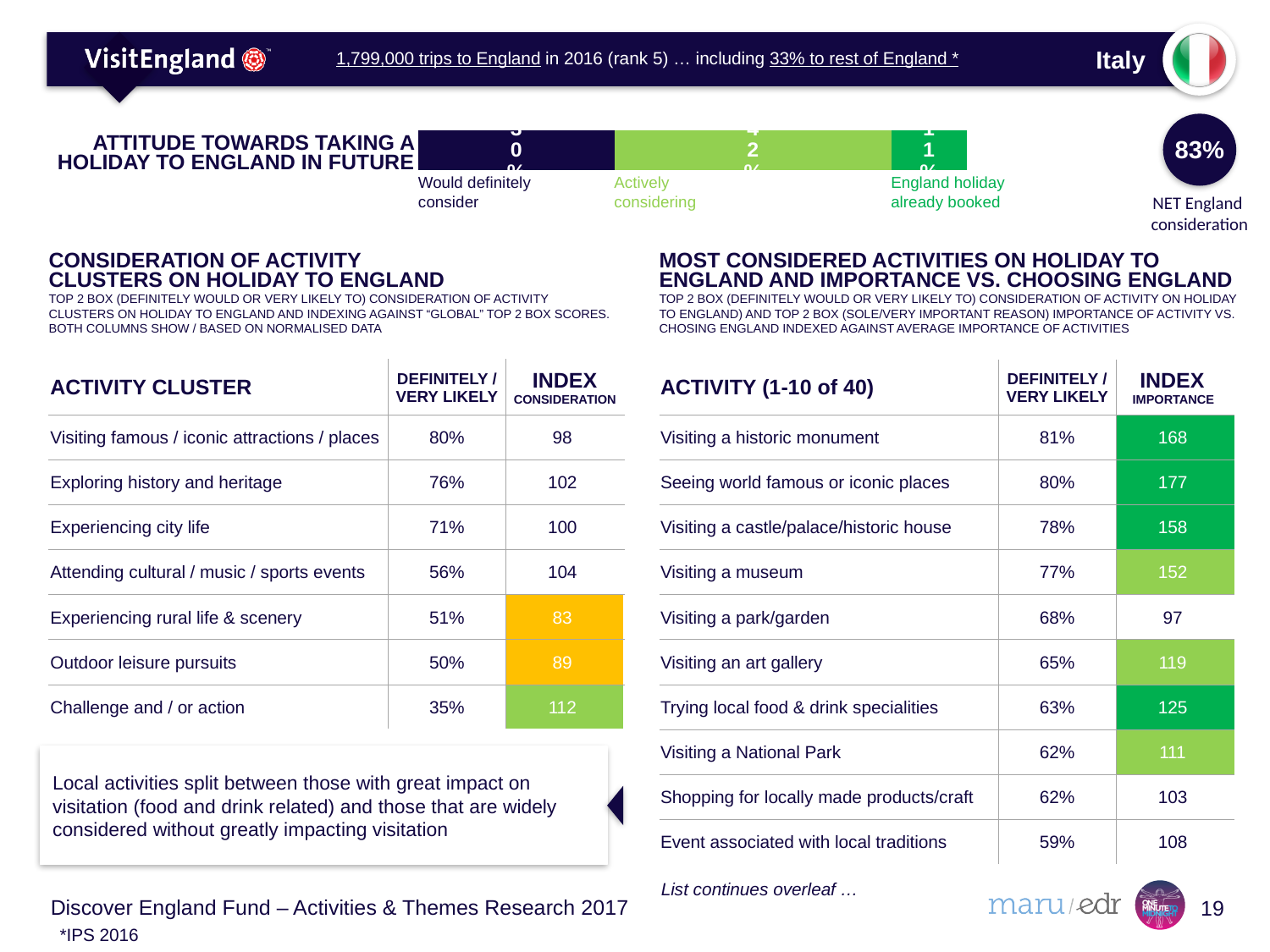
In the 'Attitude towards taking a holiday to England in future' chart, which segment is the smallest? England holiday already booked Which country does the 'Attitude towards taking a holiday to England in future' chart on this slide relate to? Italy In the 'Attitude towards taking a holiday to England in future' chart, which segment is larger: 'Would definitely consider' or 'England holiday already booked'? Would definitely consider What colour is the 'Would definitely consider' segment in the 'Attitude towards taking a holiday to England in future' chart? dark navy blue What is the NET England consideration figure shown next to the 'Attitude towards taking a holiday to England in future' chart? 83% What kind of chart is used to show the attitude towards taking a holiday to England in future? bar chart How many segments make up the stacked bar in the 'Attitude towards taking a holiday to England in future' chart? 3 In the 'Attitude towards taking a holiday to England in future' chart, which segment is the largest? Actively considering